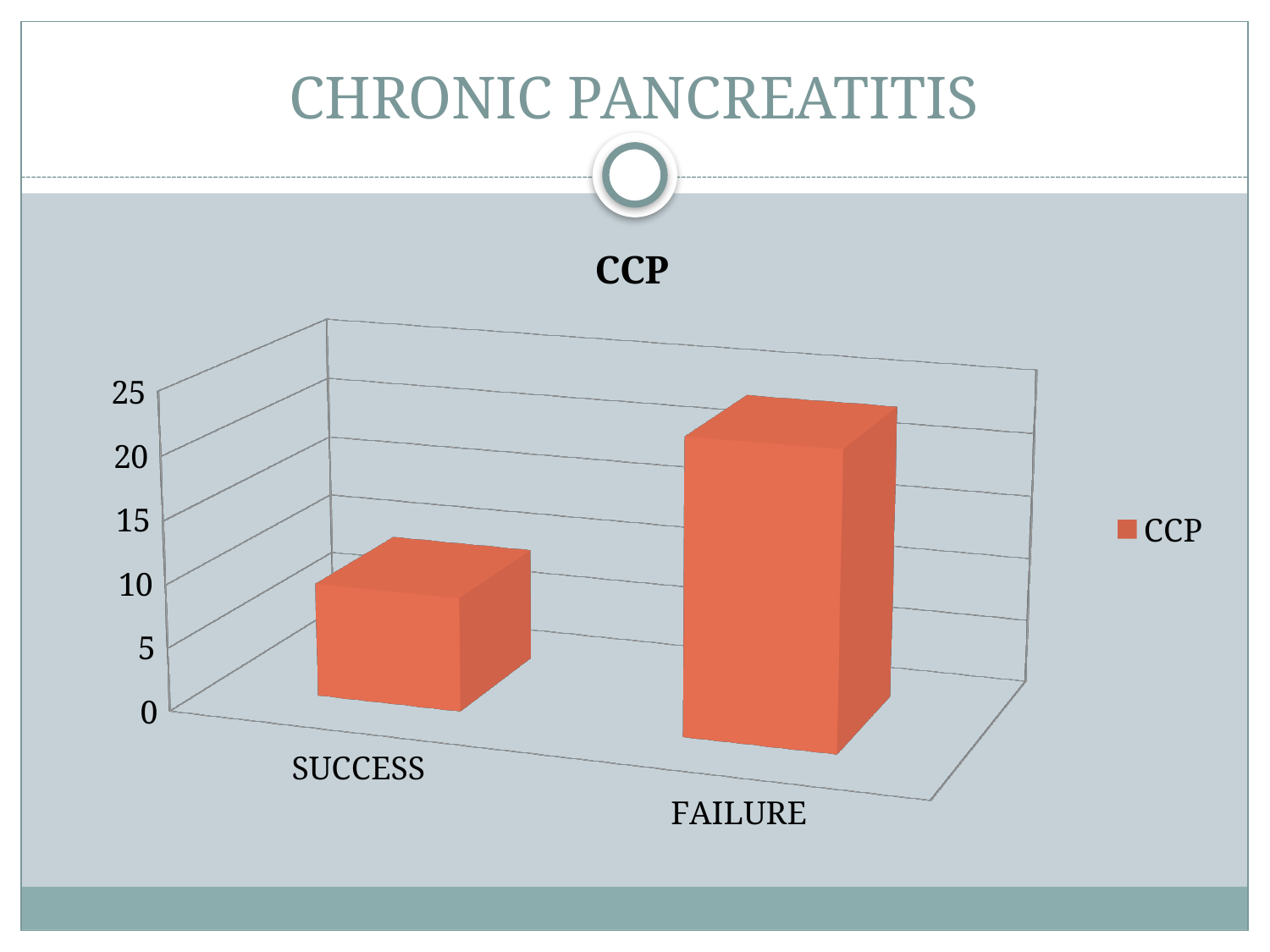
How many series does the legend list? 1 What kind of chart is shown on the slide? bar chart Is the value for FAILURE greater or less than 25? less How many categories are shown on the chart? 2 Which category has the highest value? FAILURE Which category has the lowest value? SUCCESS Is the value for SUCCESS greater or less than 15? less Which is larger, the value for SUCCESS or the value for FAILURE? FAILURE What is the title of the chart? CCP Is the value for SUCCESS greater or less than 5? greater What is the name of the series shown in the legend? CCP